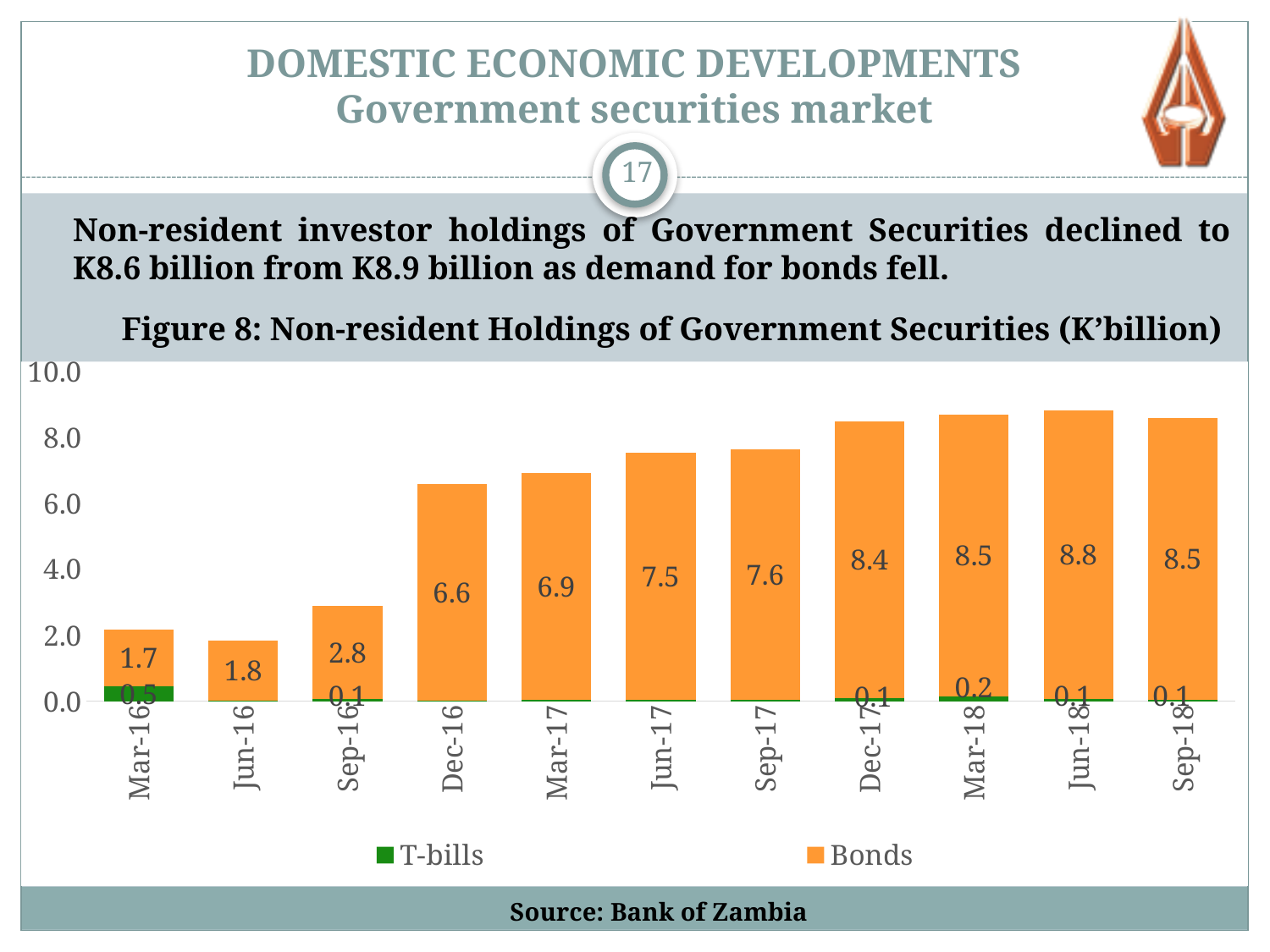
What type of chart is shown in Figure 8? Stacked bar chart What is the difference between the Bonds value for Sep-17 and for Sep-16? 4.8 In which quarter is the Bonds value highest? Jun-18 What is the total of the stacked bar for Sep-18 (T-bills plus Bonds)? 8.6 How many series does the legend list in Figure 8? 2 Which is larger, the Bonds value for Mar-17 or for Jun-17? Jun-17 Do the Bonds values generally rise or fall from Mar-16 to Jun-18? Rise What is the value of Bonds for Jun-18? 8.8 How many quarters (categories) are shown on the x axis of Figure 8? 11 What is the value of Bonds for Dec-16? 6.6 In which quarter is the Bonds value lowest? Mar-16 What is the value of T-bills for Mar-16? 0.5